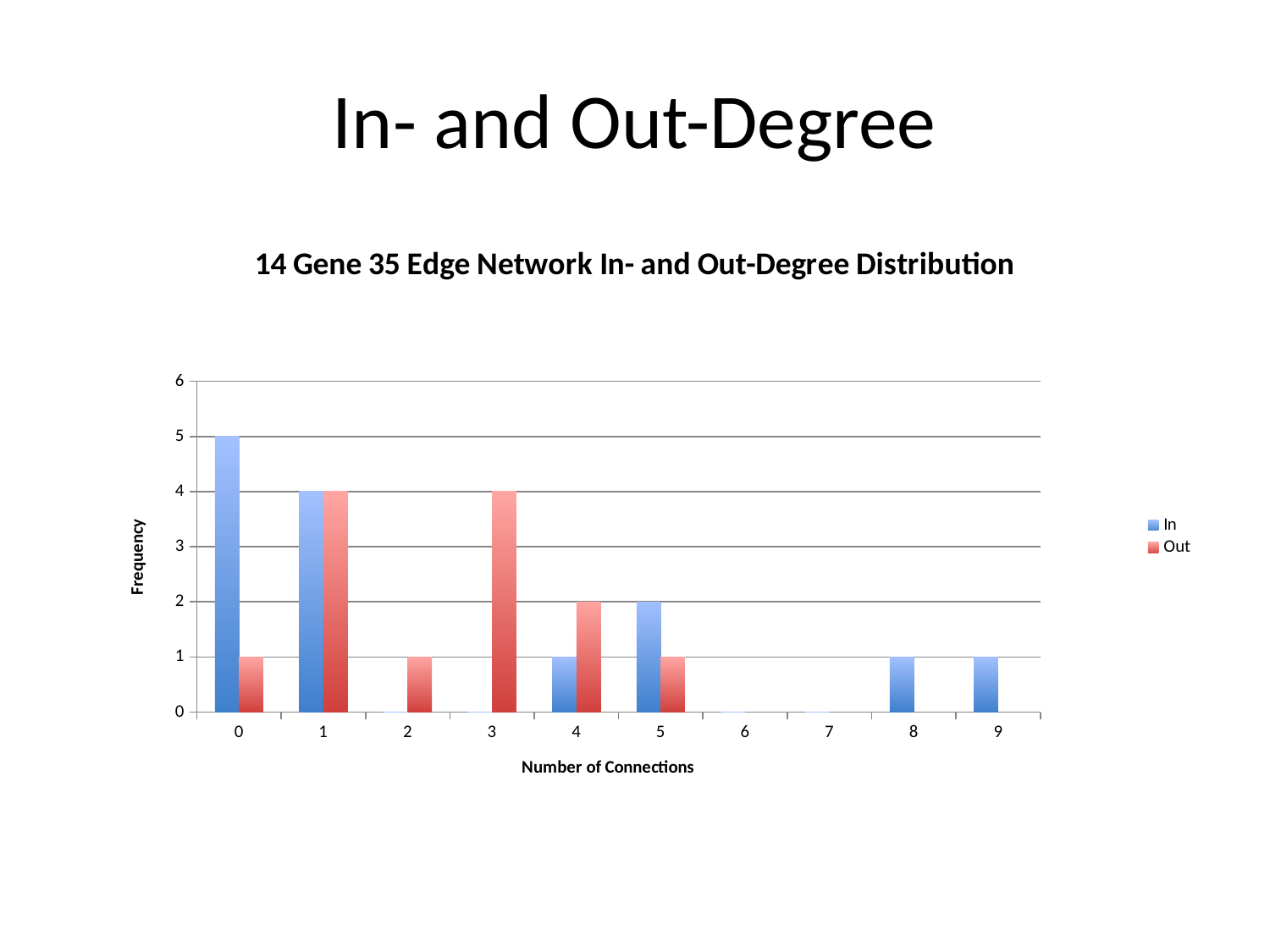
How many categories are shown on the x axis? 10 What is the difference between the In frequency and the Out frequency at 0 connections? 4 Which is larger at 5 connections, the In frequency or the Out frequency? In Which number of connections has the highest frequency for the In series? 0 Is the In frequency at 1 connection greater or less than 3? greater What is the frequency for the Out series at 4 connections? 2 What kind of chart is shown on the slide? bar chart What is the frequency for the In series at 0 connections? 5 How many series does the legend list? 2 What is the title of the chart? 14 Gene 35 Edge Network In- and Out-Degree Distribution What is the frequency for the Out series at 3 connections? 4 What is the label of the y axis? Frequency